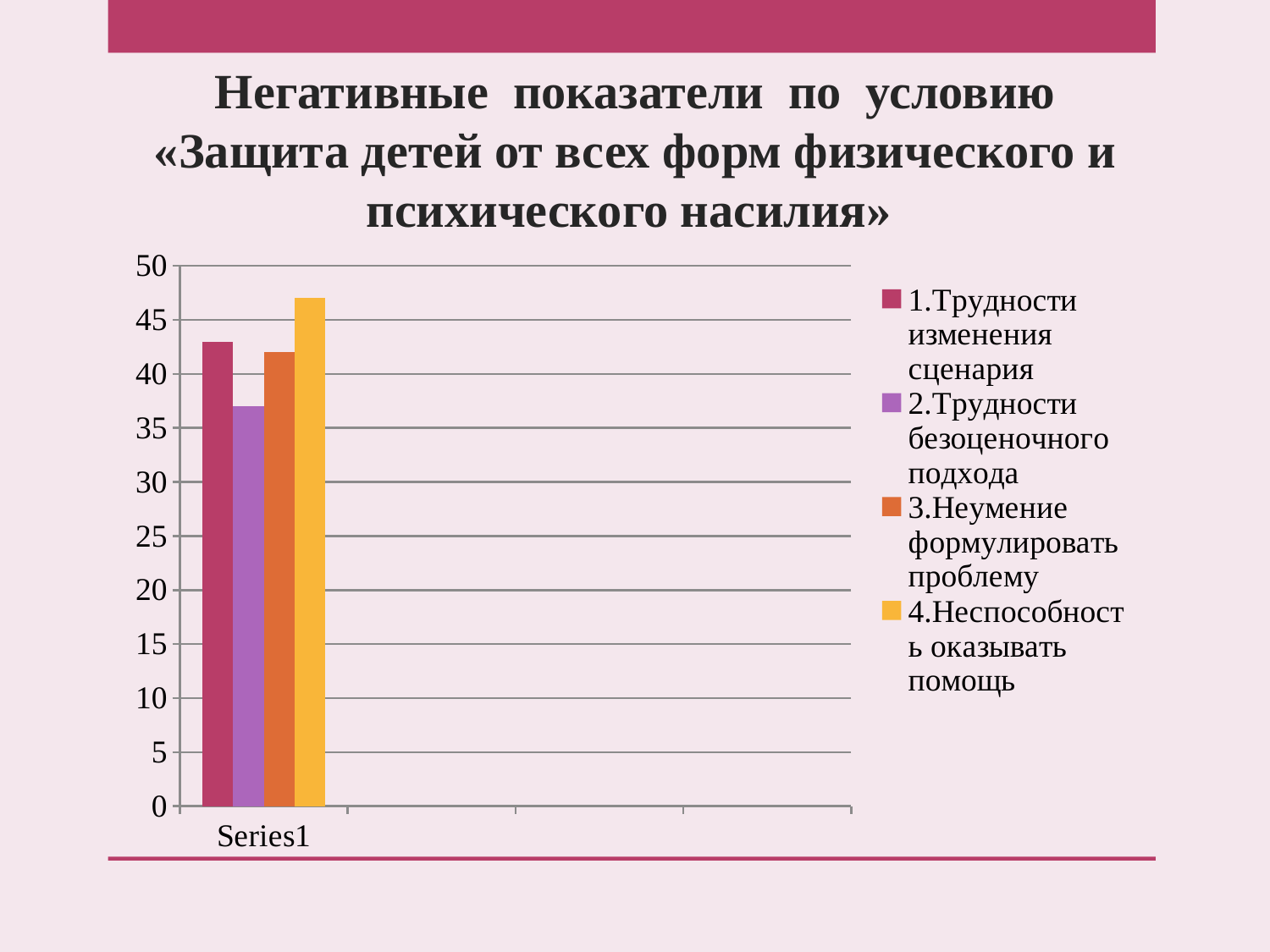
Which is larger, the value for "3.Неумение формулировать проблему" or the value for "4.Неспособность оказывать помощь"? 4.Неспособность оказывать помощь Which is larger, the value for "1.Трудности изменения сценария" or the value for "2.Трудности безоценочного подхода"? 1.Трудности изменения сценария What kind of chart is shown on the slide? bar chart Is the value for "1.Трудности изменения сценария" greater or less than 40? greater Is the value for "2.Трудности безоценочного подхода" greater or less than 40? less Which series has the lowest bar? 2.Трудности безоценочного подхода Which series has the highest bar? 4.Неспособность оказывать помощь How many categories are shown on the x axis? 1 Is the value for "2.Трудности безоценочного подхода" greater or less than 35? greater What is the label of the single category on the x axis? Series1 How many series does the legend list? 4